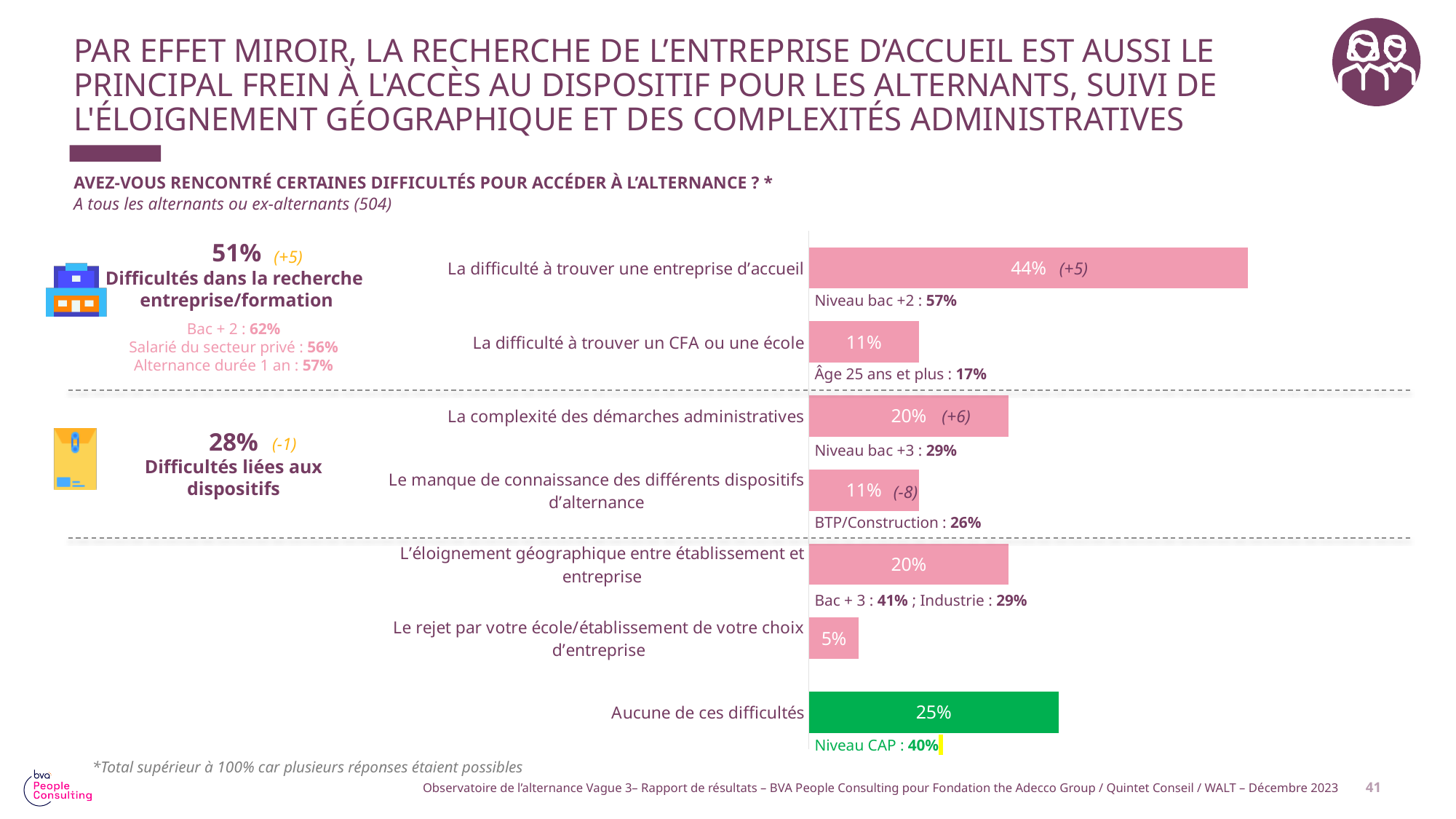
What is the value for "La difficulté à trouver une entreprise d'accueil"? 44% How many categories are shown in the bar chart? 7 What is the change shown in parentheses next to the 44% bar? (+5) What is the value for "Le rejet par votre école/établissement de votre choix d'entreprise"? 5% What is the difference between the value for "La difficulté à trouver une entreprise d'accueil" and the value for "Aucune de ces difficultés"? 19% Which category has the lowest value? Le rejet par votre école/établissement de votre choix d'entreprise Which category has the highest value? La difficulté à trouver une entreprise d'accueil What is the value for "La difficulté à trouver un CFA ou une école"? 11% Which is larger: the value for "La complexité des démarches administratives" or the value for "Le manque de connaissance des différents dispositifs d'alternance"? La complexité des démarches administratives Which bar is coloured green rather than pink? Aucune de ces difficultés What kind of chart is shown on the slide? Bar chart What is the value for "Aucune de ces difficultés"? 25%